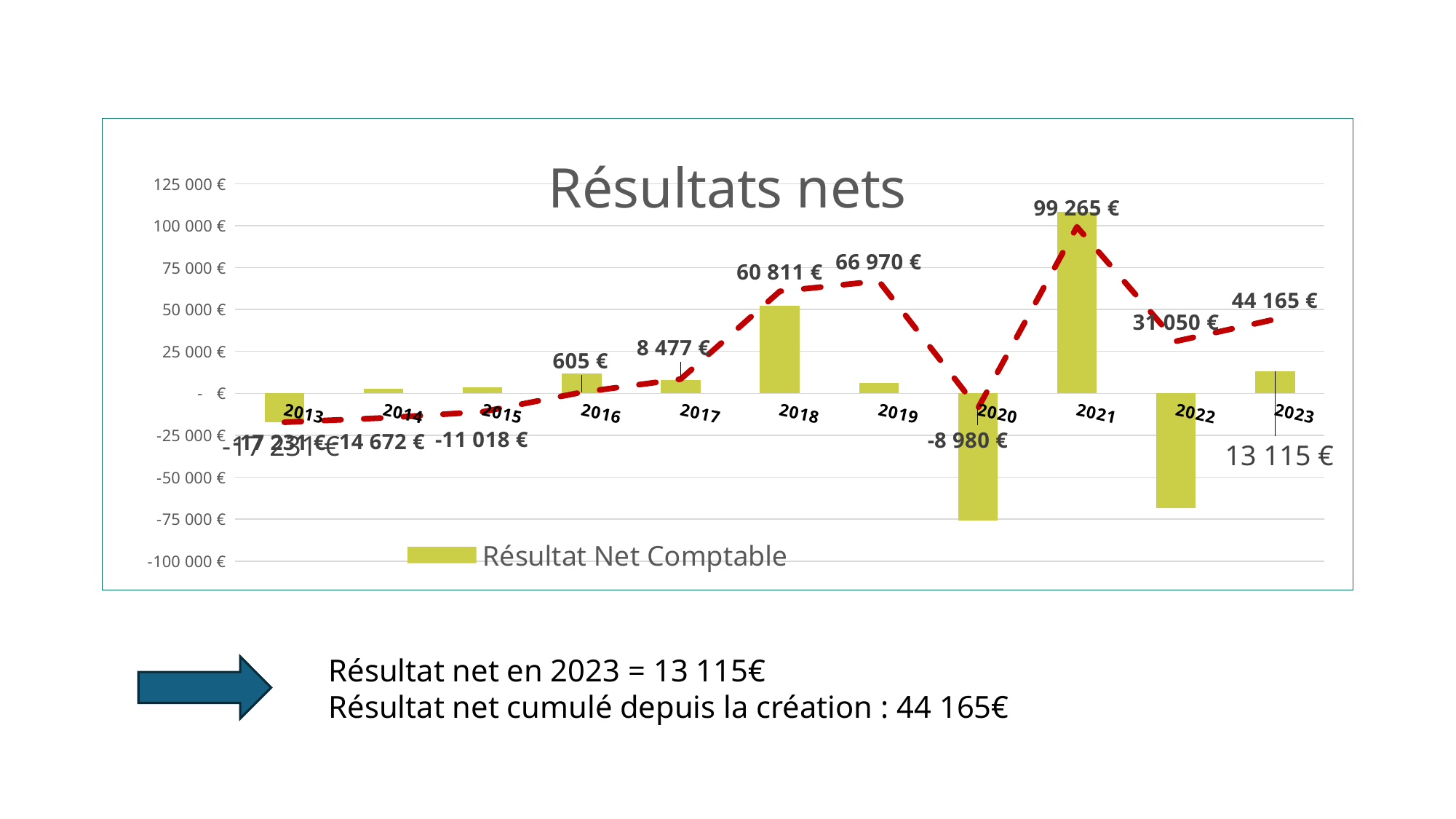
What is the difference between the dashed line values for 2021 (99 265 €) and 2022 (31 050 €)? 68 215 € What value does the dashed line show for 2021? 99 265 € What type of chart is used to show the Résultat Net Comptable series? Bar chart How many series does the legend list? 1 Is the Résultat Net Comptable bar for 2020 greater or less than -50 000 €? less What is the title of the chart? Résultats nets How many years are shown on the x axis? 11 Which year has the lowest Résultat Net Comptable bar? 2020 Which year has the highest Résultat Net Comptable bar? 2021 Which year has the larger Résultat Net Comptable bar, 2018 or 2019? 2018 What is the Résultat Net Comptable value for 2023? 13 115 €